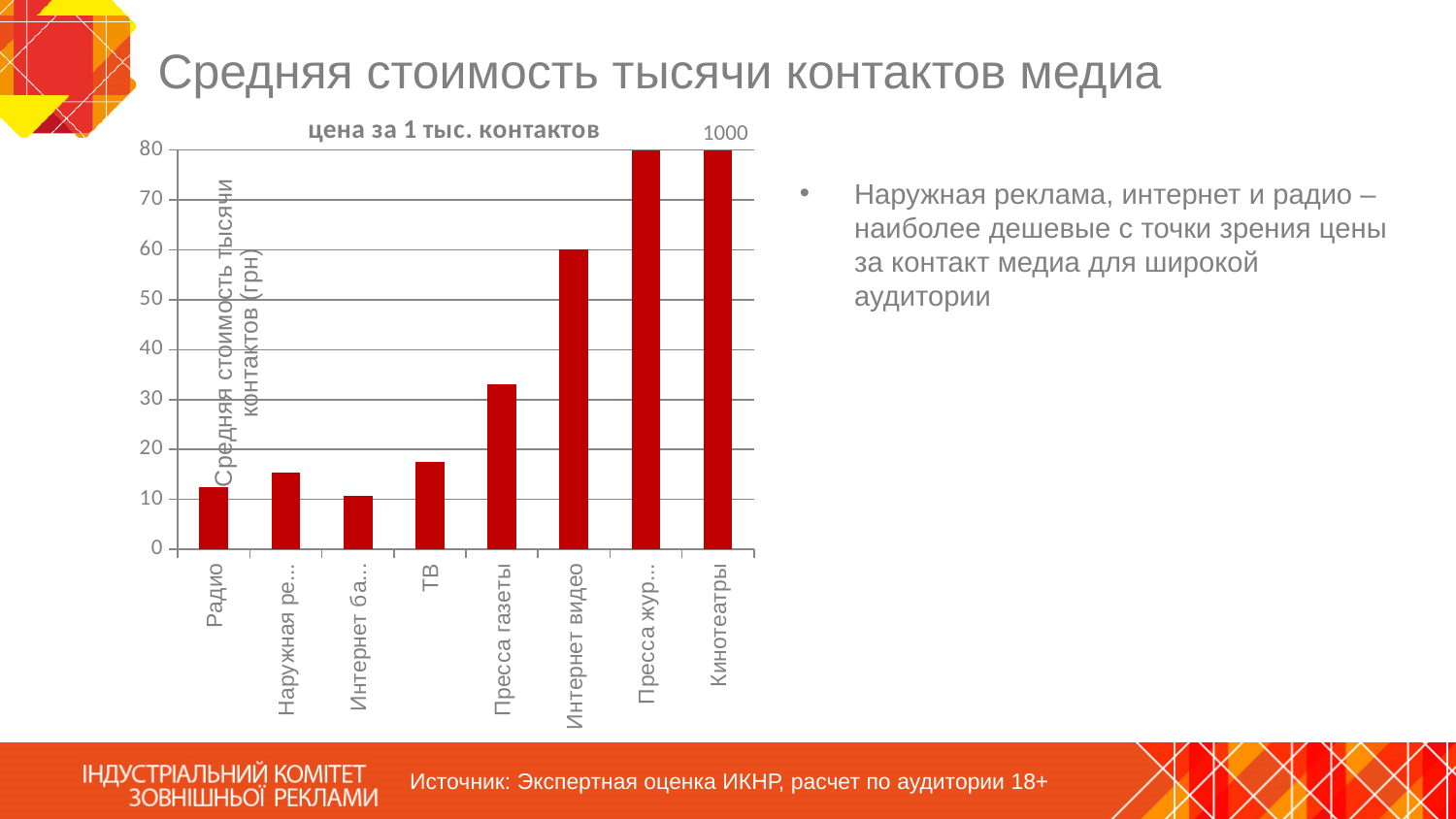
Which is larger, the value for Интернет видео or the value for Пресса газеты? Интернет видео What kind of chart is shown on the slide? Bar chart Is the value for Интернет видео greater or less than 50? greater Which is larger, the value for ТВ or the value for Радио? ТВ What colour are the bars in the chart? Red Is the value for Радио greater or less than 20? less What is the title of the chart? цена за 1 тыс. контактов What is the data label shown for Кинотеатры? 1000 Is the value for ТВ greater or less than 20? less Do the values generally rise or fall from left to right along the x axis? rise How many categories are plotted in the chart? 8